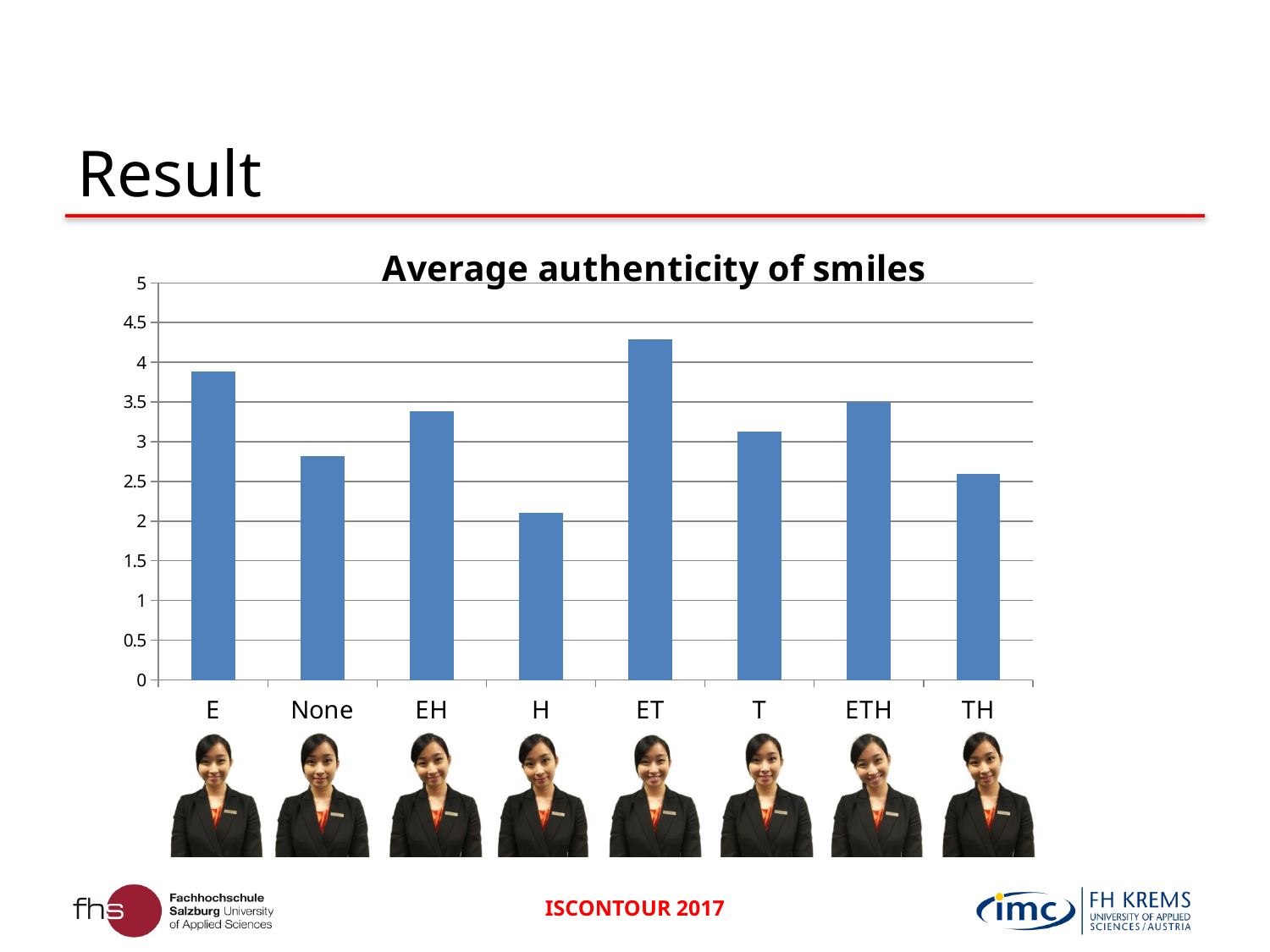
Is the value for ET greater or less than 4? greater Which has a higher average authenticity of smiles, H or TH? TH Which category has the lowest average authenticity of smiles? H What type of chart is shown on the slide? bar chart Is the value for TH greater or less than 3? less Is the value for E greater or less than 3.5? greater Which has a higher average authenticity of smiles, E or None? E How many categories are shown on the x axis of the chart? 8 Which category has the highest average authenticity of smiles? ET What is the title of the chart? Average authenticity of smiles